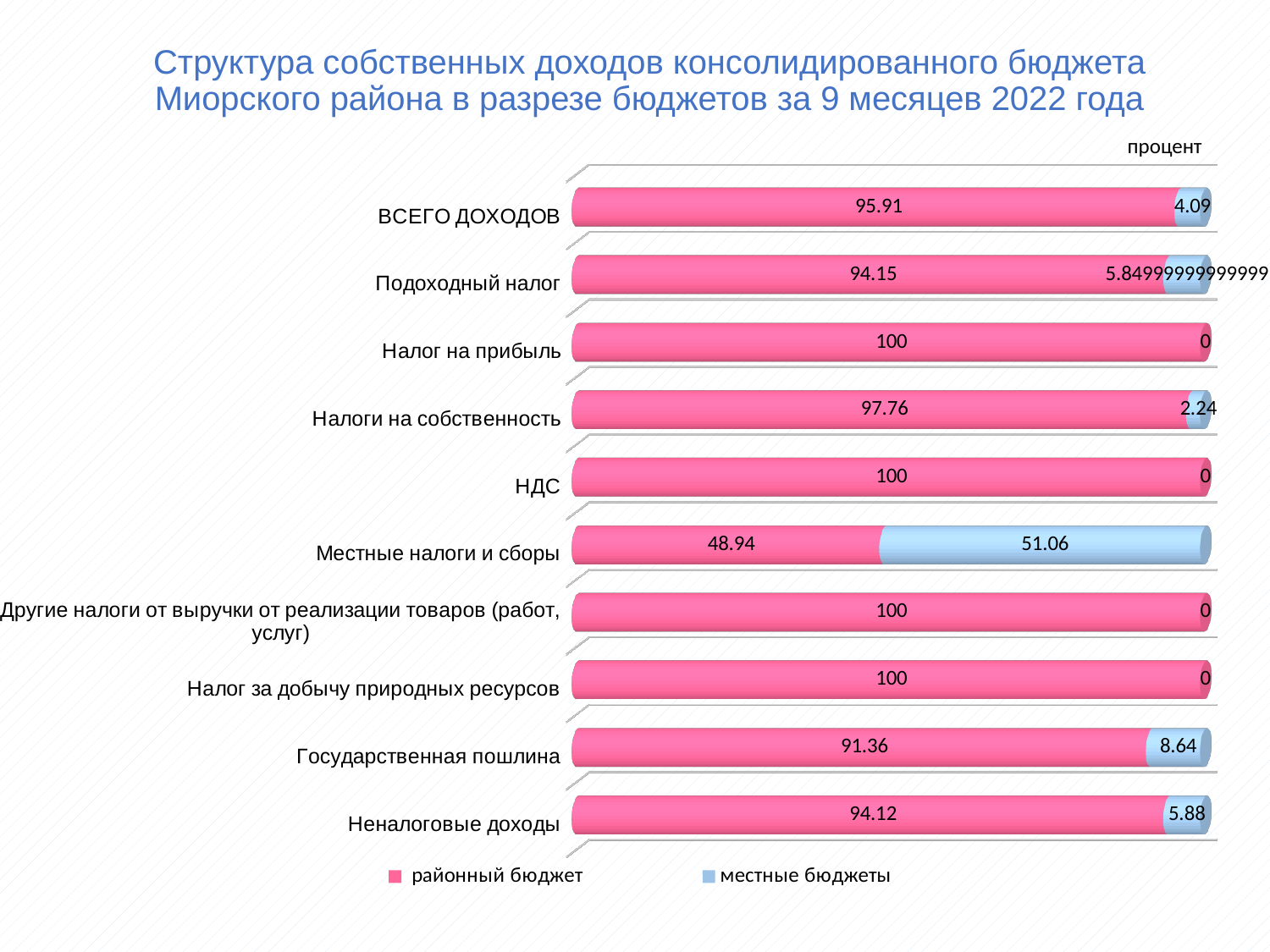
What is the value of местные бюджеты for Государственная пошлина? 8.64 For Государственная пошлина, what is the difference between районный бюджет and местные бюджеты? 82.72 How many series does the legend list? 2 What kind of chart is shown on the slide? Stacked bar chart What is the value of районный бюджет for ВСЕГО ДОХОДОВ? 95.91 Which category has the highest value for местные бюджеты? Местные налоги и сборы What is the value of местные бюджеты for Местные налоги и сборы? 51.06 What is the value of районный бюджет for Неналоговые доходы? 94.12 Which is larger: местные бюджеты for Государственная пошлина or местные бюджеты for Неналоговые доходы? Государственная пошлина Which category has the lowest value for районный бюджет? Местные налоги и сборы How many categories are shown on the chart? 10 What are the two series named in the legend? районный бюджет and местные бюджеты